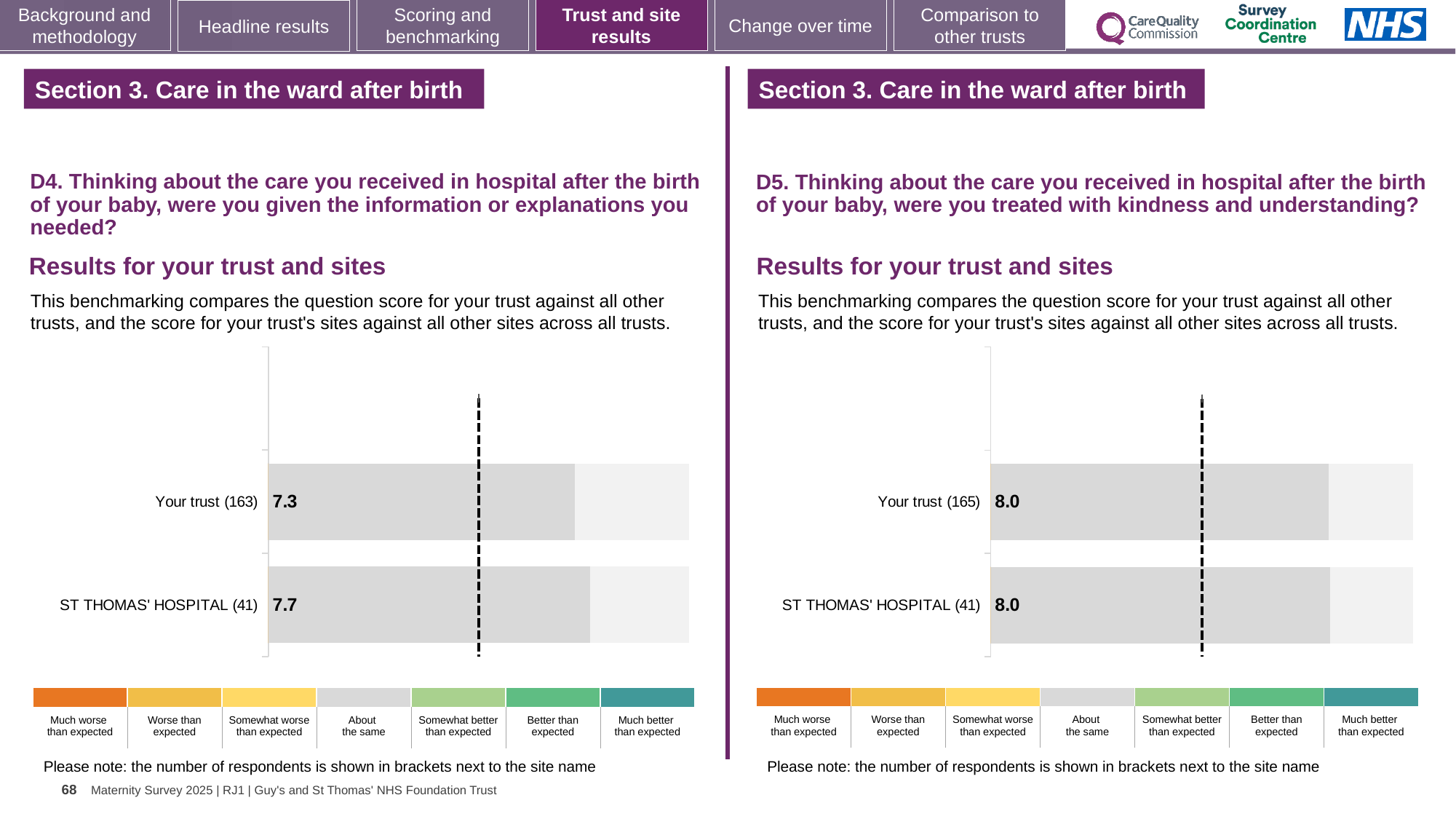
In the D4 chart on the left, how many respondents are shown in brackets for Your trust? 163 In the D5 chart on the right, what is the score for Your trust? 8.0 How many bars are plotted in the D4 chart on the left? 2 In the D5 chart on the right, what is the difference between the Your trust score and the ST THOMAS' HOSPITAL score? 0.0 In the D4 chart on the left, what is the difference between the ST THOMAS' HOSPITAL score and the Your trust score? 0.4 In the D4 chart on the left, what is the score for Your trust? 7.3 In the D4 chart on the left, which has the higher score, Your trust or ST THOMAS' HOSPITAL? ST THOMAS' HOSPITAL How many bars are plotted in the D5 chart on the right? 2 What type of chart is used in the D4 chart on the left? Bar chart In the D4 chart on the left, what is the score for ST THOMAS' HOSPITAL? 7.7 In the D5 chart on the right, what is the score for ST THOMAS' HOSPITAL? 8.0 In the D5 chart on the right, how many respondents are shown in brackets for Your trust? 165